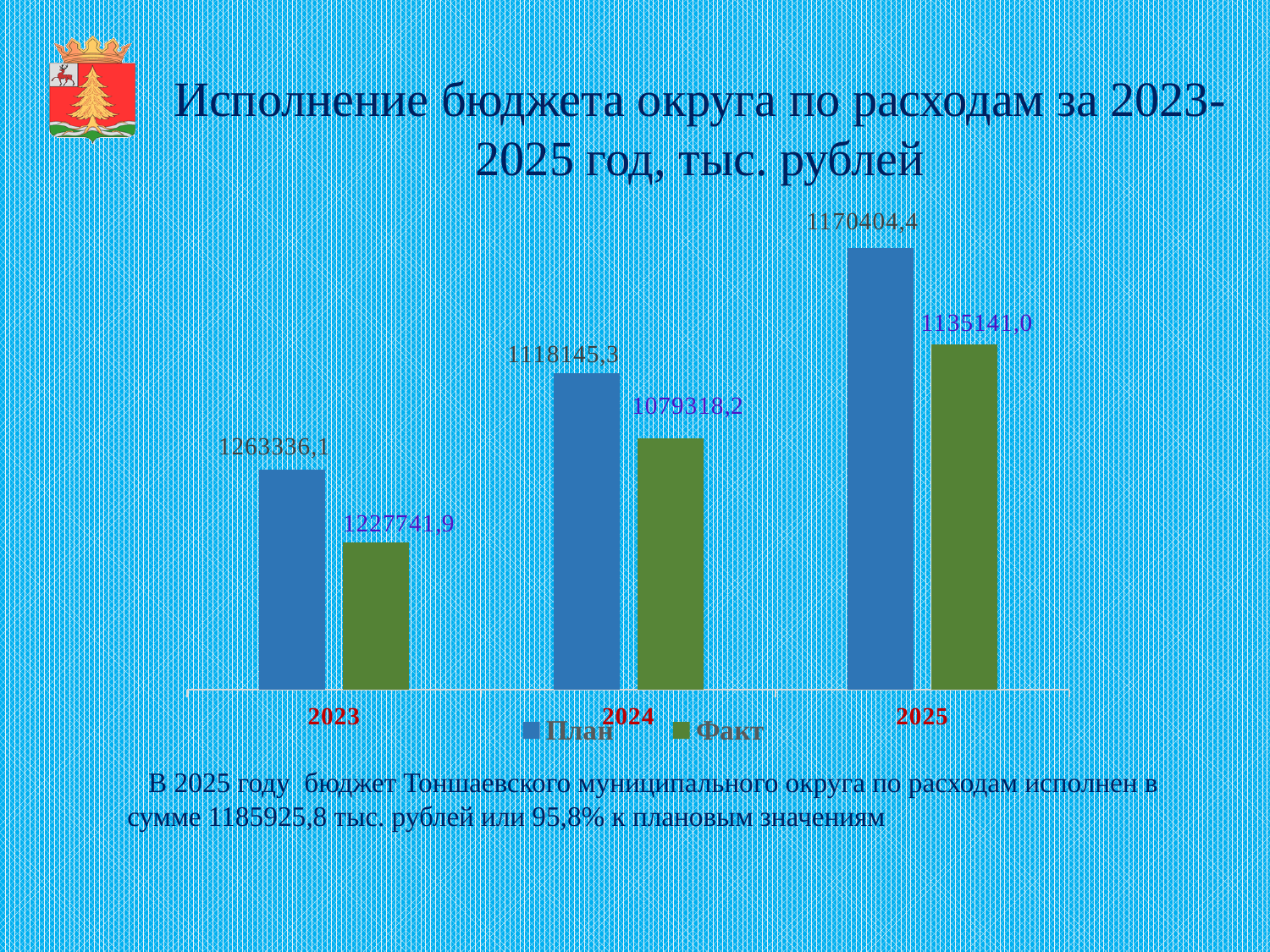
What is the value of Факт for 2025? 1135141,0 What is the value of План for 2025? 1170404,4 How many years are shown on the x axis? 3 What is the value of Факт for 2023? 1227741,9 What kind of chart is shown on the slide? bar chart What is the difference between План and Факт for 2023? 35594,2 What is the value of План for 2024? 1118145,3 Which is larger for 2025, План or Факт? План What is the value of Факт for 2024? 1079318,2 What is the value of План for 2023? 1263336,1 What is the difference between План and Факт for 2024? 38827,1 How many series does the legend list? 2